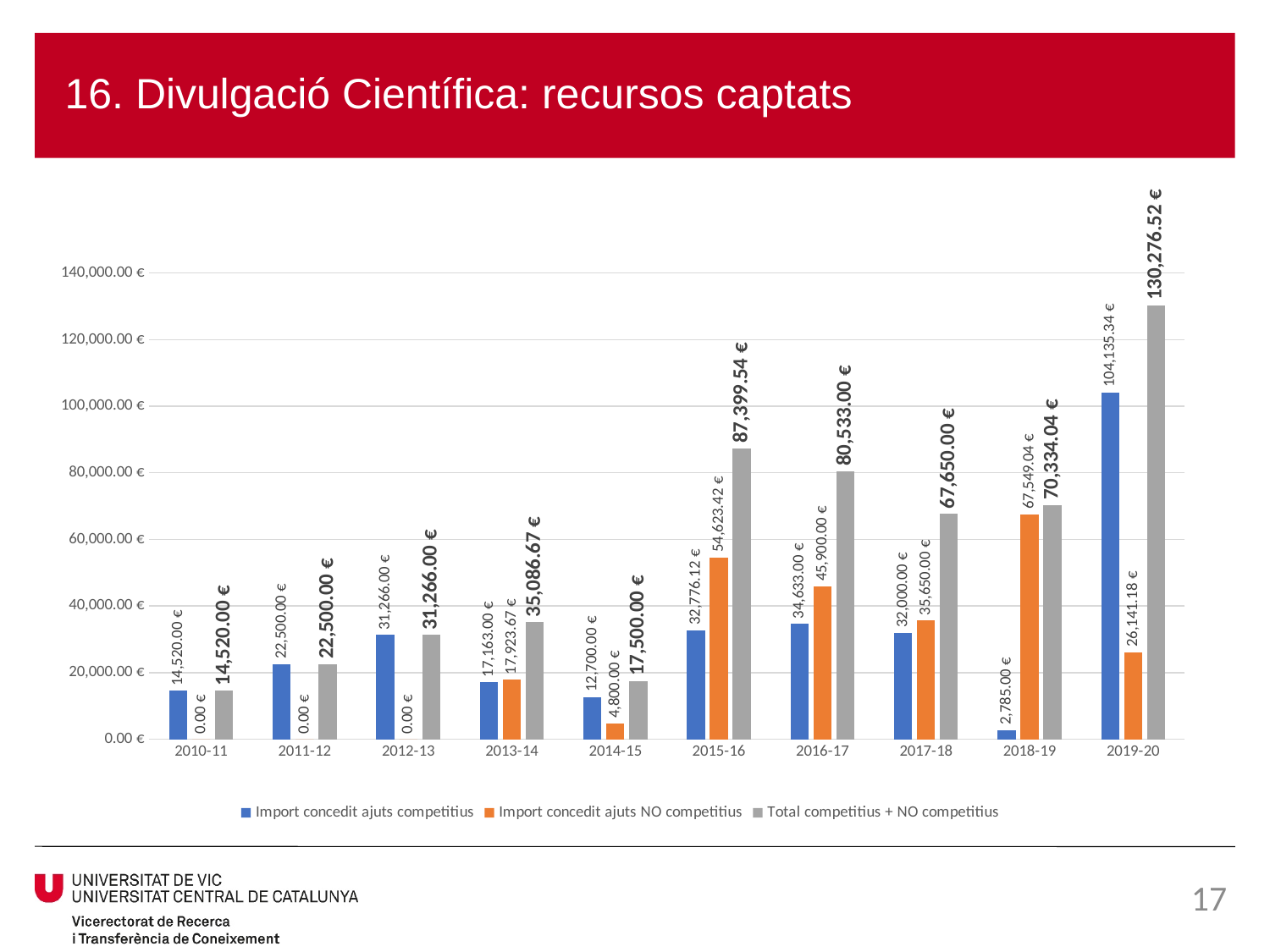
What is the difference between the "Total competitius + NO competitius" values for 2015-16 and 2016-17? 6,866.54 € Which is larger in 2017-18: "Import concedit ajuts competitius" or "Import concedit ajuts NO competitius"? Import concedit ajuts NO competitius How many series does the legend list? 3 What is the value of "Import concedit ajuts competitius" for 2019-20? 104,135.34 € What kind of chart is shown on the slide? Bar chart Is the "Total competitius + NO competitius" value for 2019-20 greater or less than 120,000.00 €? greater What is the value of "Import concedit ajuts NO competitius" for 2015-16? 54,623.42 € Which year has the lowest "Import concedit ajuts competitius" value? 2018-19 How many academic years are shown on the x axis? 10 Which colour represents "Total competitius + NO competitius" in the chart? Grey Which year has the highest "Total competitius + NO competitius" value? 2019-20 What is the "Total competitius + NO competitius" value for 2016-17? 80,533.00 €